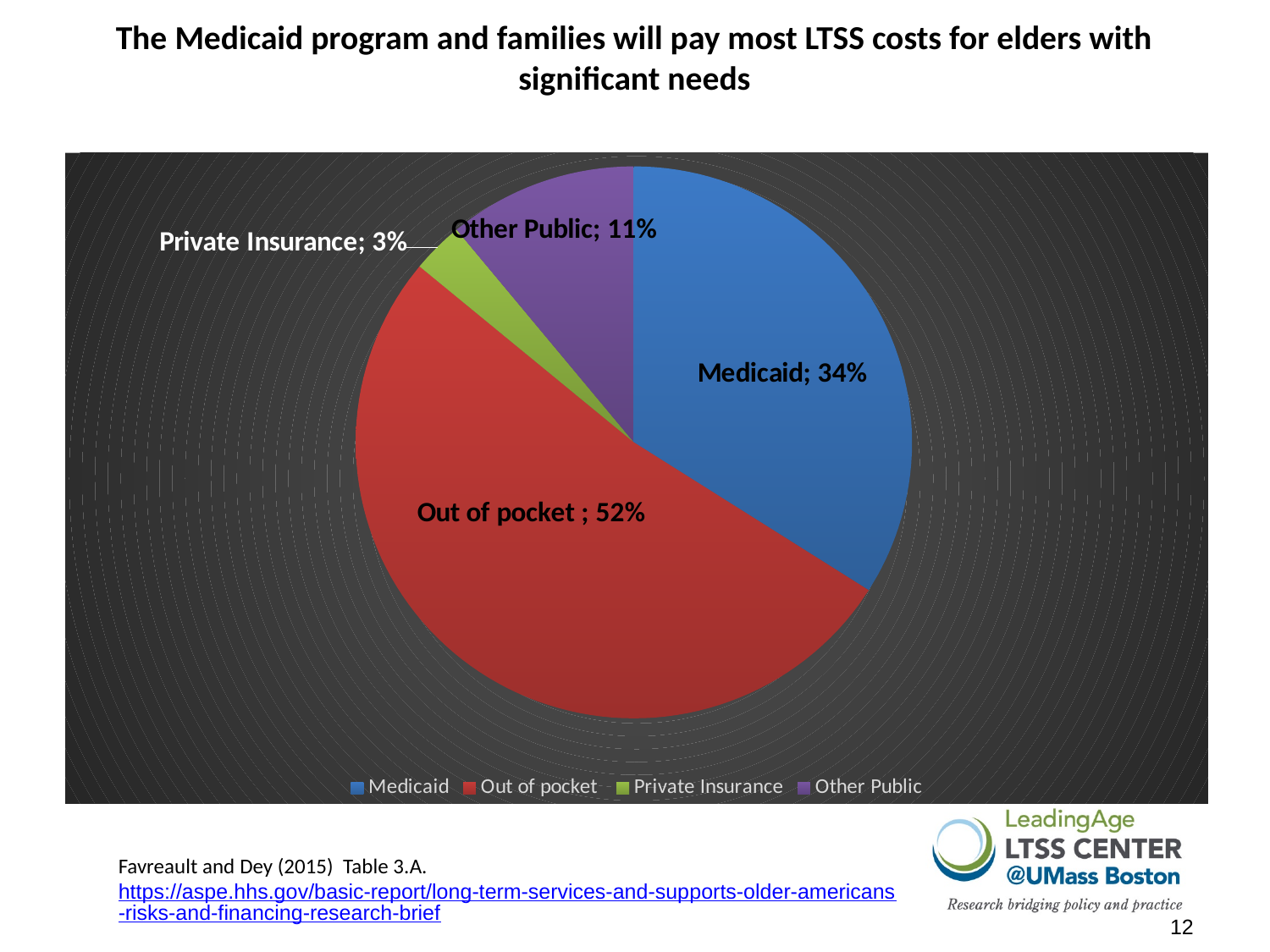
Which is larger, the Other Public share or the Private Insurance share? Other Public How many entries does the legend list? 4 How many percentage points larger is the out-of-pocket share than the Medicaid share? 18 What share of LTSS costs is paid by other public sources? 11% Which payer has the smallest share of the pie? Private Insurance What share of LTSS costs is paid out of pocket? 52% Which payer has the largest share of the pie? Out of pocket What colour is the Out of pocket slice? Red What kind of chart is shown on the slide? Pie chart How many slices does the pie chart have? 4 What share of LTSS costs is paid by private insurance? 3% What share of LTSS costs is paid by Medicaid? 34%